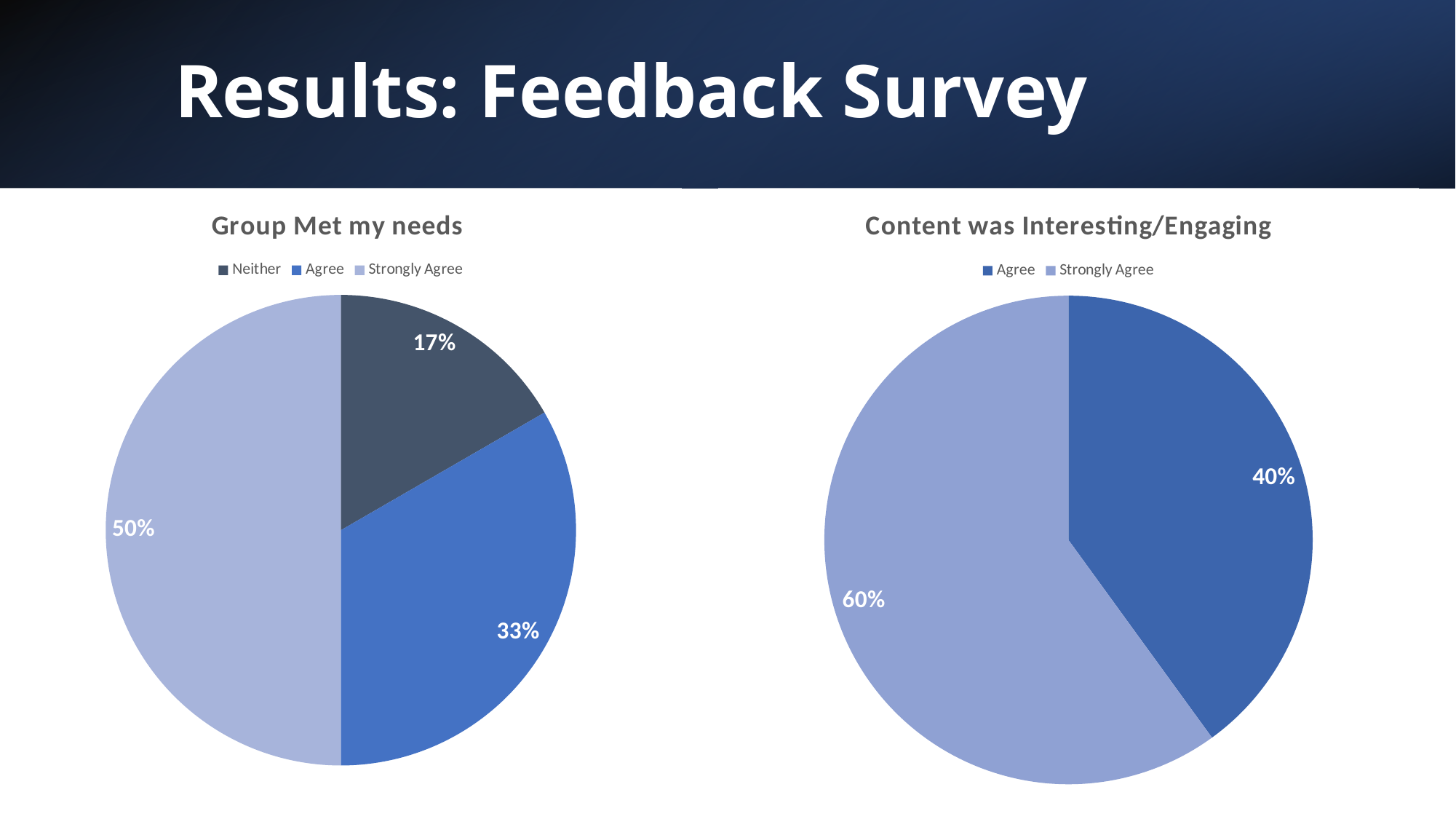
In the 'Group Met my needs' chart, what percentage of respondents answered Neither? 17% In the 'Group Met my needs' chart, which response has the largest share? Strongly Agree In the 'Group Met my needs' chart, what percentage of respondents answered Strongly Agree? 50% In the 'Content was Interesting/Engaging' chart, what is the difference in percentage points between Strongly Agree and Agree? 20 In the 'Group Met my needs' chart, what percentage of respondents answered Agree? 33% In the 'Content was Interesting/Engaging' chart, which response has the larger share, Agree or Strongly Agree? Strongly Agree In the 'Content was Interesting/Engaging' chart, what percentage of respondents answered Agree? 40% How many categories does the legend of the 'Group Met my needs' chart list? 3 In the 'Group Met my needs' chart, which response has the smallest share? Neither In the 'Content was Interesting/Engaging' chart, what percentage of respondents answered Strongly Agree? 60% In the 'Group Met my needs' chart, what is the difference in percentage points between Strongly Agree and Neither? 33 What type of chart is the 'Content was Interesting/Engaging' chart? Pie chart